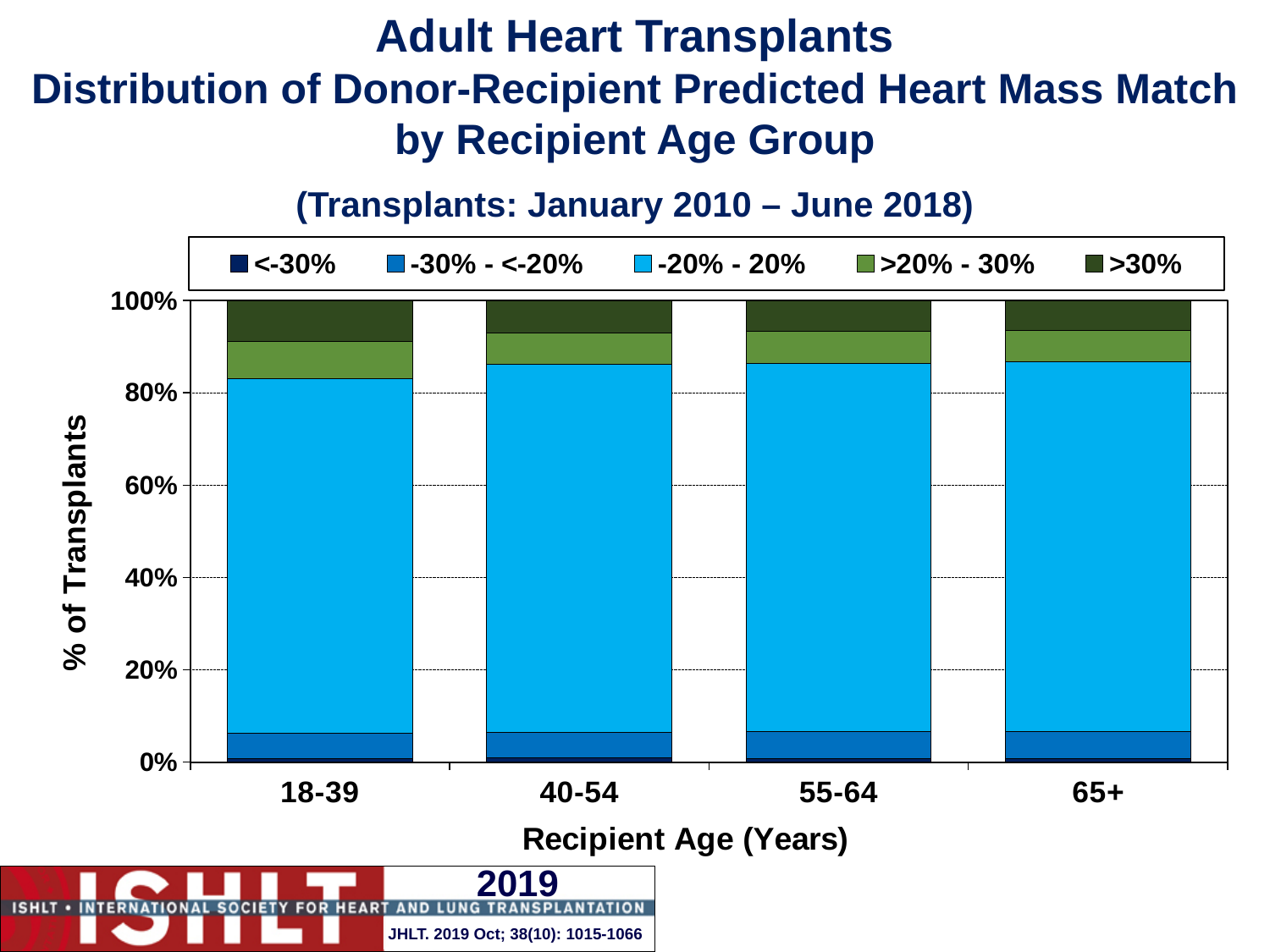
Which recipient age group has the smallest -20% - 20% share? 18-39 Is the -20% - 20% share for the 18-39 age group greater or less than 60%? greater Is the >30% share for the 18-39 age group greater or less than 20%? less What kind of chart is shown on the slide? Stacked bar chart Is the <-30% share for the 65+ age group greater or less than 20%? less Which series occupies the largest portion of every bar? -20% - 20% What is the label of the x axis? Recipient Age (Years) Which recipient age group has the largest >30% share? 18-39 What is the label of the y axis? % of Transplants How many recipient age groups are shown on the x axis? 4 How many series does the legend list? 5